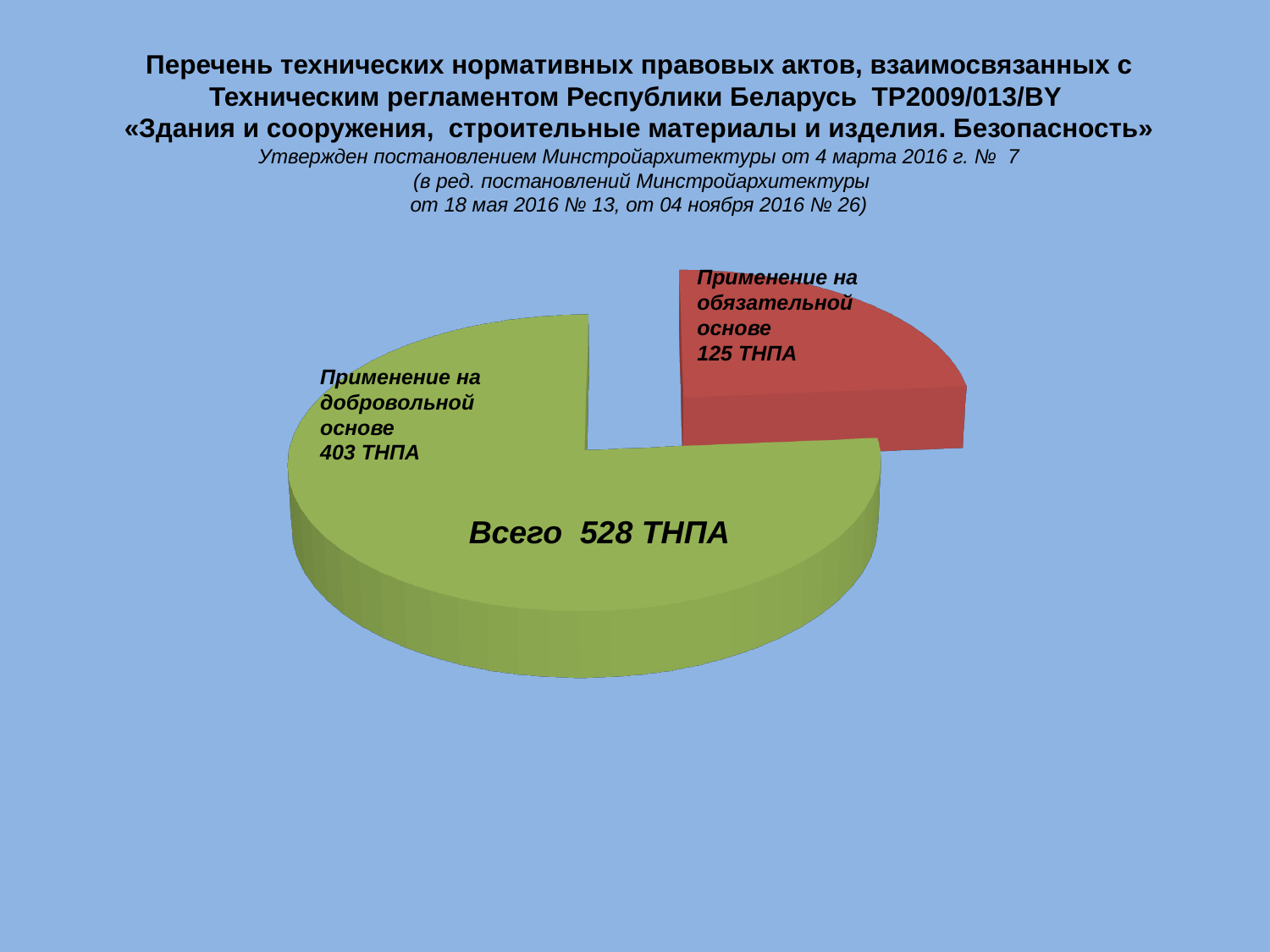
How many ТНПА are applied on a voluntary basis (Применение на добровольной основе) according to the pie chart? 403 ТНПА What colour is the slice for ТНПА applied on a mandatory basis? Red How many slices does the pie chart have? 2 Which is larger: the number of ТНПА applied on a voluntary basis or on a mandatory basis? Voluntary basis (добровольной основе) Which slice of the pie chart is the largest? Применение на добровольной основе What colour is the slice for ТНПА applied on a voluntary basis? Green By how many ТНПА does the voluntary-basis slice exceed the mandatory-basis slice? 278 How many ТНПА are applied on a mandatory basis (Применение на обязательной основе) according to the pie chart? 125 ТНПА What is the total number of ТНПА shown in the pie chart? 528 ТНПА What kind of chart is shown on the slide? Pie chart Which slice of the pie chart is the smallest? Применение на обязательной основе